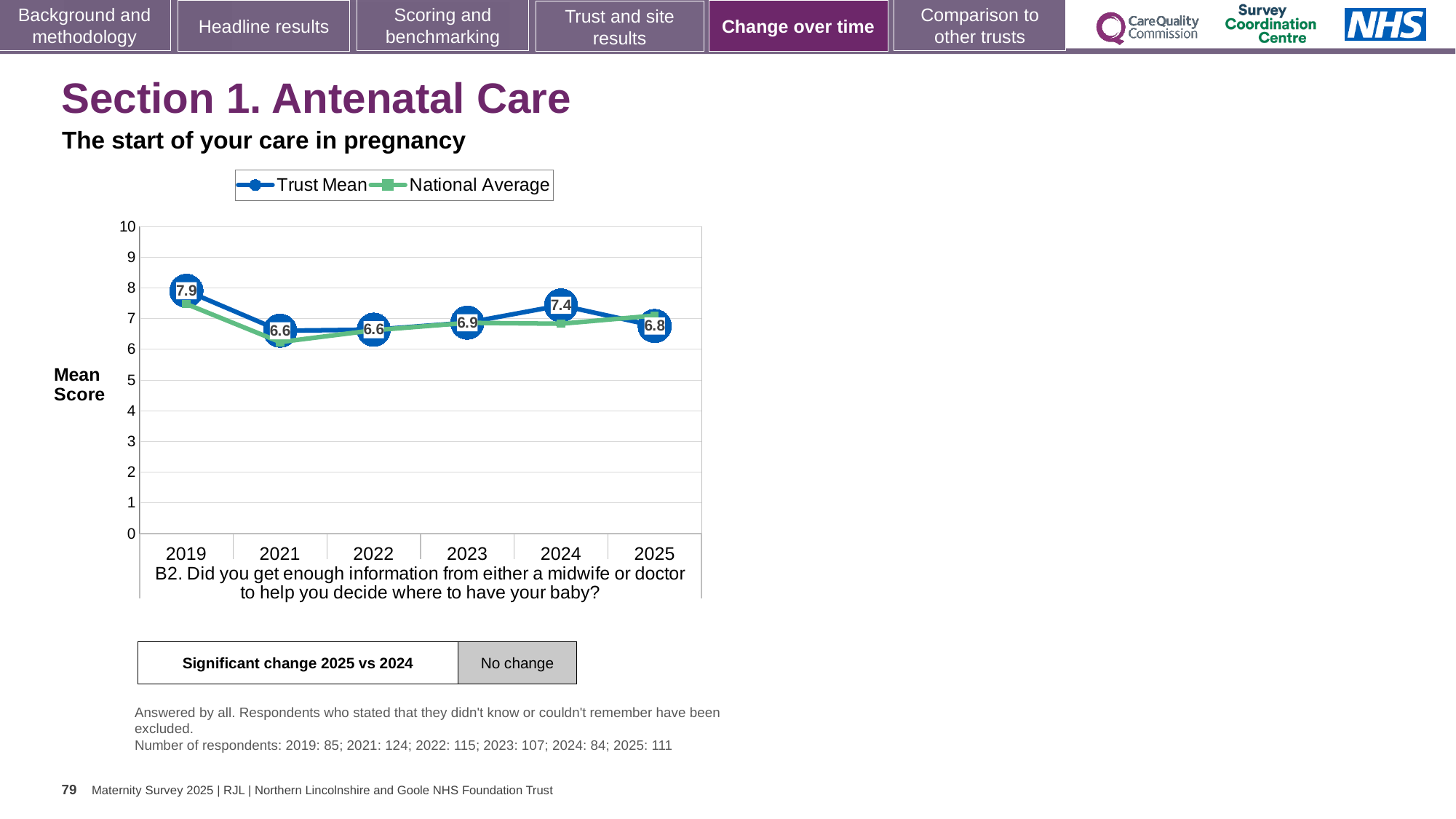
What is the difference between the Trust Mean in 2024 and in 2023? 0.5 What is the Trust Mean value for 2024? 7.4 Which year has the larger Trust Mean, 2024 or 2025? 2024 Is the National Average value for 2021 greater or less than 7? less What is the Trust Mean value for 2025? 6.8 How many years are plotted on the x axis? 6 In which year is the Trust Mean highest? 2019 Does the Trust Mean rise or fall from 2024 to 2025? fall What is the difference between the Trust Mean in 2019 and in 2025? 1.1 How many series does the legend list? 2 What is the Trust Mean value for 2019? 7.9 What kind of chart is shown on the slide? line chart